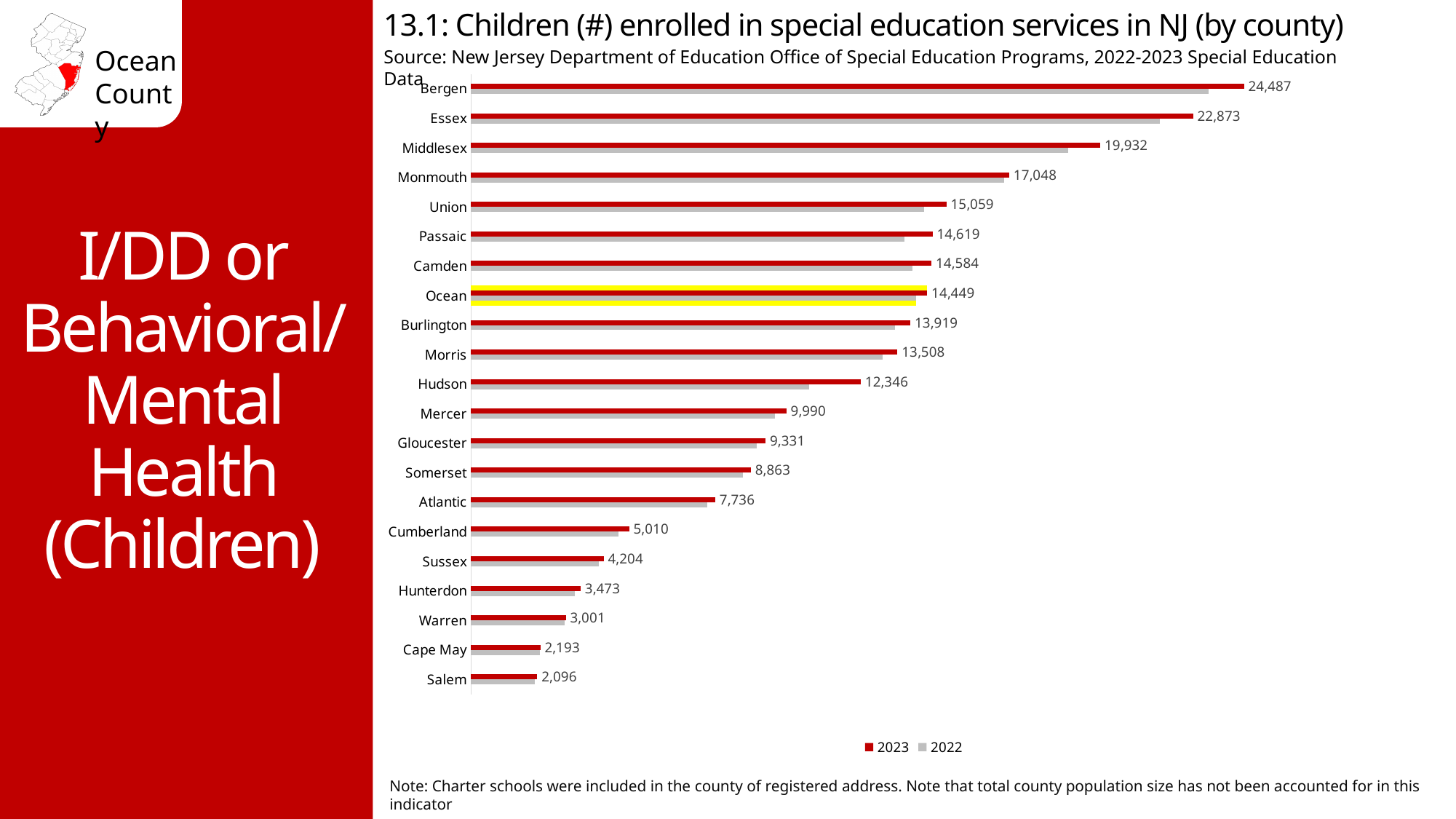
What is the difference between the 2023 values for Bergen and Essex? 1,614 What is the 2023 value for Bergen county? 24,487 Which county has the highest 2023 value? Bergen Which county has the lowest 2023 value? Salem What kind of chart is shown on the slide? Bar chart How many series does the legend list? 2 How many counties are shown on the chart? 21 What is the 2023 value for Ocean county? 14,449 What is the 2023 value for Cumberland county? 5,010 What is the difference between the 2023 values for Ocean and Burlington? 530 Which has a larger 2023 value, Hudson or Mercer? Hudson Which county's bars are highlighted in yellow? Ocean